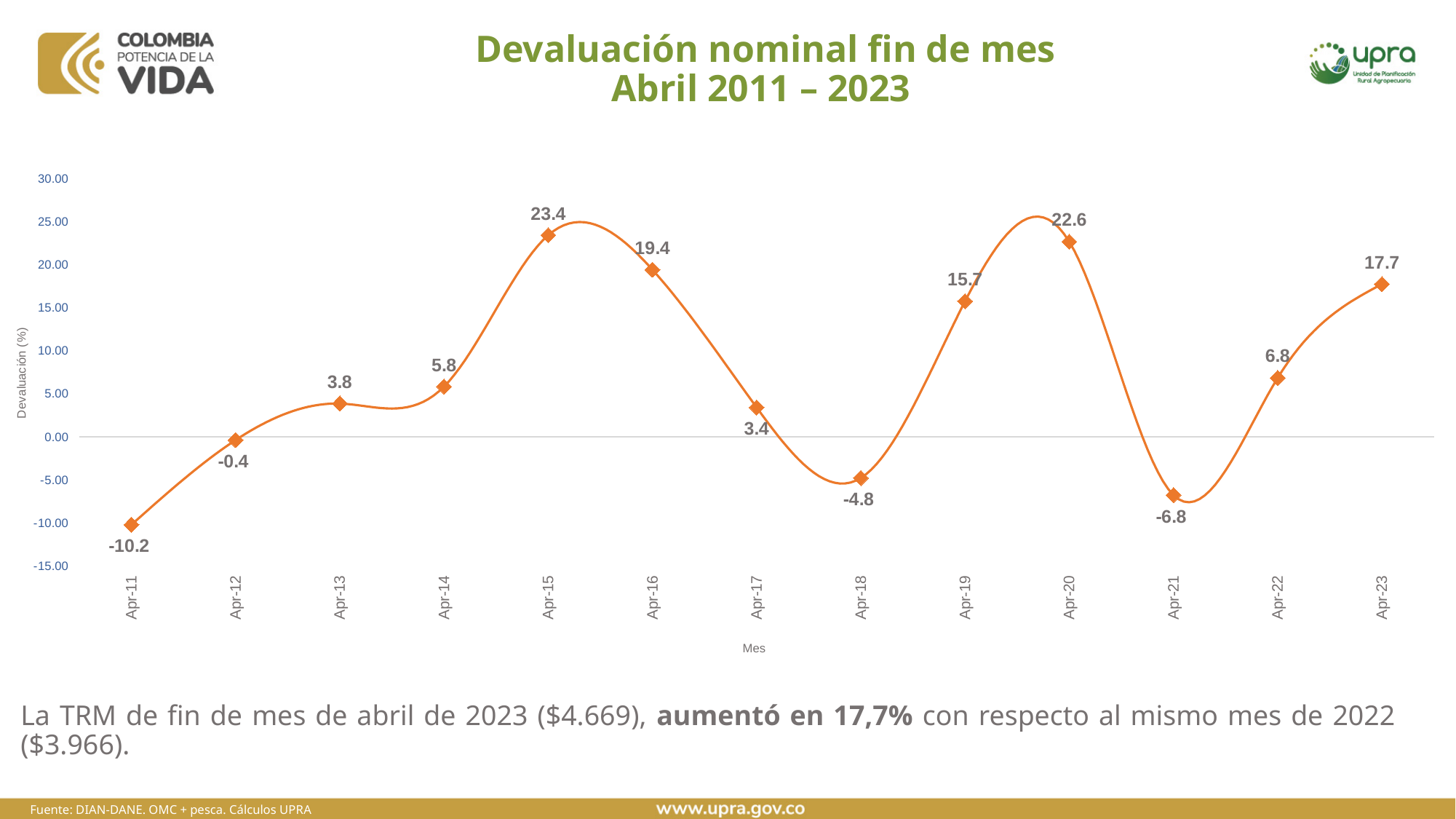
What is the label of the vertical axis? Devaluación (%) Is the value for Apr-18 greater or less than 0.00? less Which is larger, the value for Apr-16 or the value for Apr-22? Apr-16 How many data points are plotted on the chart? 13 What is the value for Apr-21? -6.8 Which month has the highest value? Apr-15 What is the value for Apr-11? -10.2 Which month has the lowest value? Apr-11 What is the value for Apr-15? 23.4 What is the value for Apr-23? 17.7 What is the difference between the values for Apr-20 and Apr-19? 6.9 What kind of chart is shown on the slide? line chart